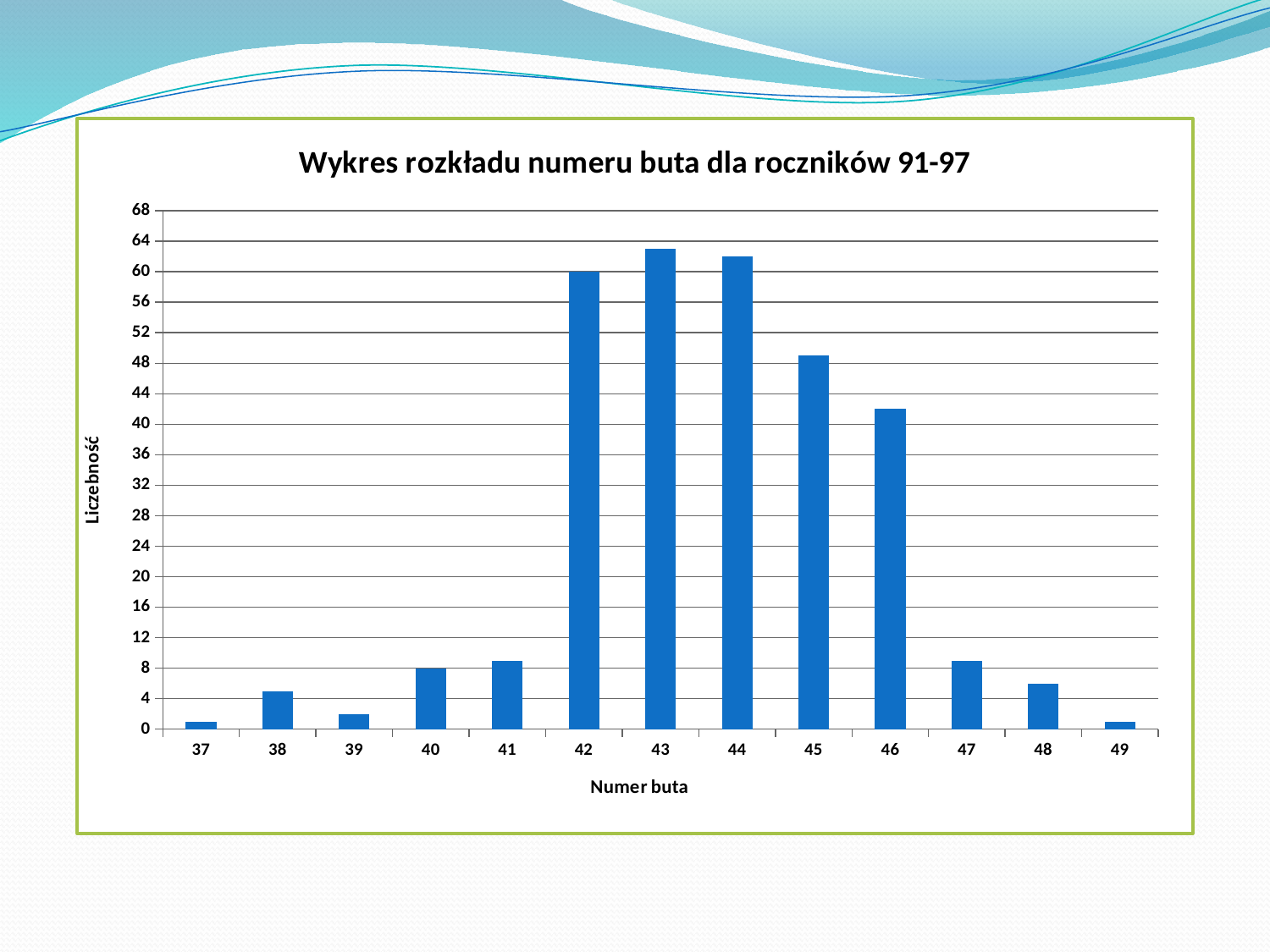
Is the value for shoe size 47 greater or less than 12? less What is the label of the x axis? Numer buta Is the value for shoe size 43 greater or less than 60? greater What is the title of the chart? Wykres rozkładu numeru buta dla roczników 91-97 Which has a larger value, shoe size 39 or shoe size 41? 41 How many shoe size categories are shown on the x axis? 13 Which has a larger value, shoe size 45 or shoe size 46? 45 What kind of chart is shown on the slide? bar chart What is the value (Liczebność) for shoe size 40? 8 What is the value (Liczebność) for shoe size 42? 60 Is the value for shoe size 46 greater or less than 40? greater